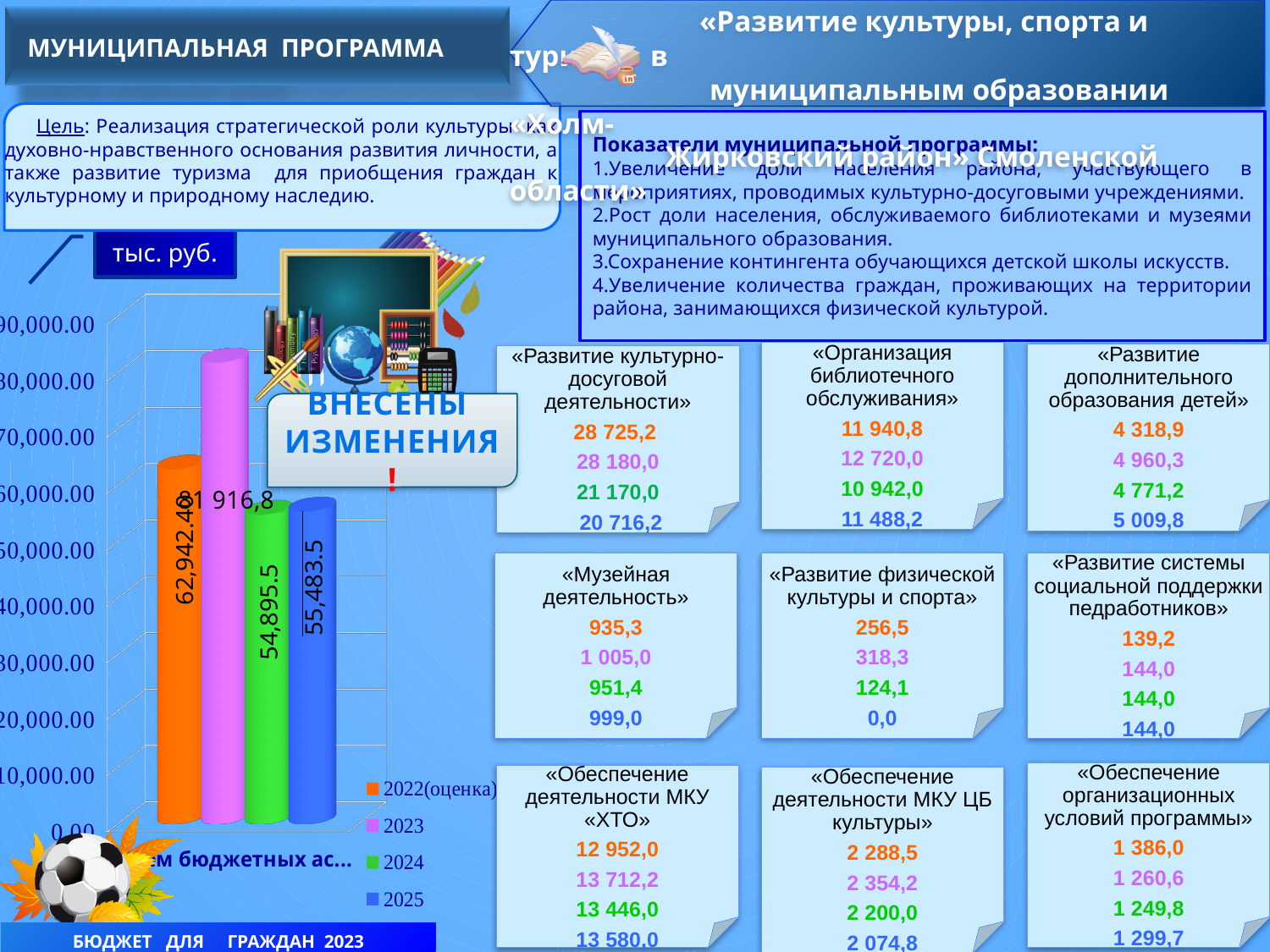
Which year has the lowest bar in the chart? 2024 Which year has the highest bar in the chart? 2023 Is the value for 2023 greater or less than 70,000.00? greater What kind of chart is shown on the slide? bar chart How many bars are plotted in the chart? 4 What unit is indicated for the chart values in the label above the chart? тыс. руб. What is the difference between the values for 2025 and 2024? 588.0 What is the value of the bar for 2024? 54,895.5 What is the value of the bar for 2023? 81 916,8 How many series does the chart legend list? 4 What is the value of the bar for 2025? 55,483.5 Is the value for 2022(оценка) greater or less than 50,000.00? greater